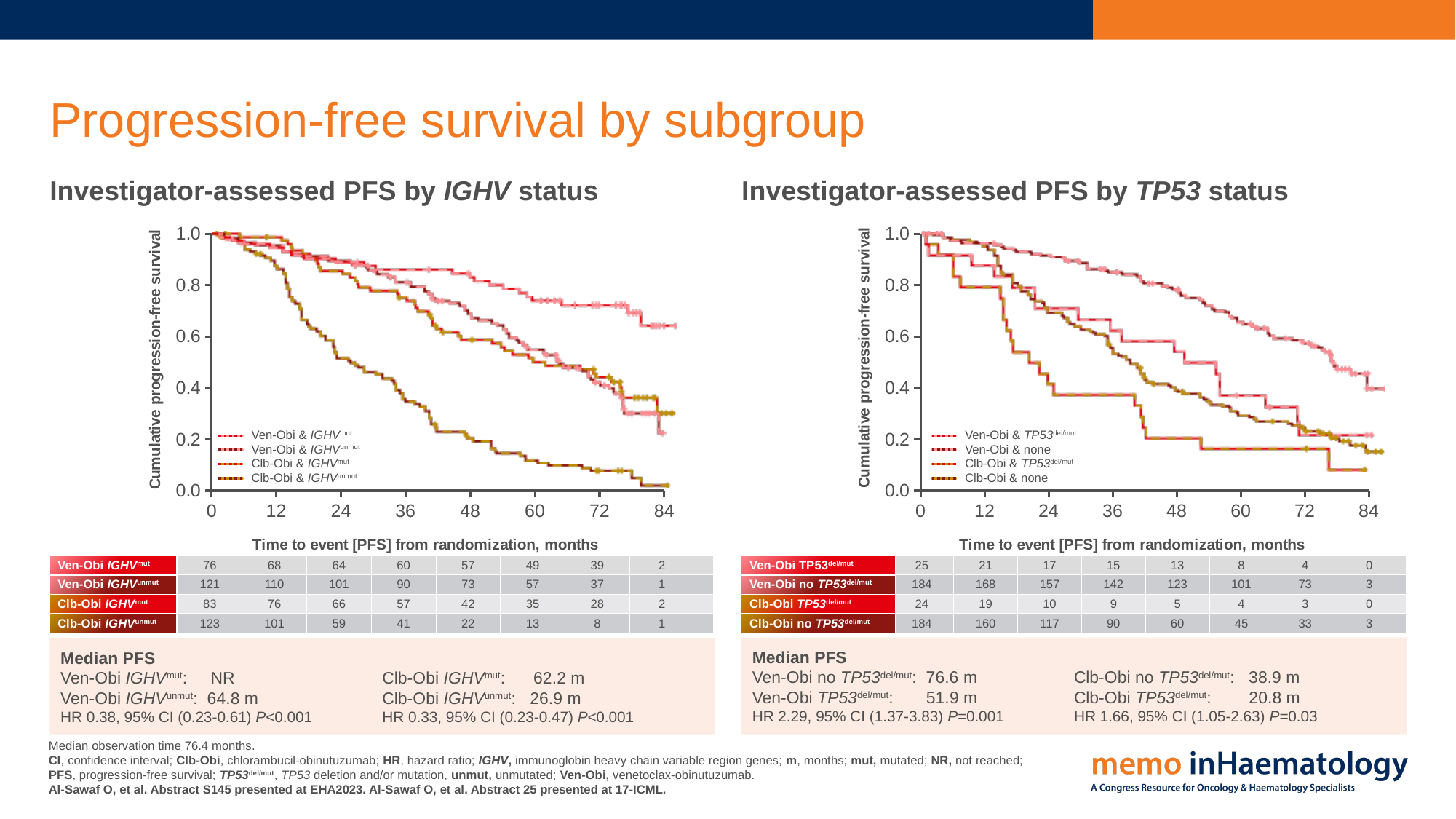
In the chart 'Investigator-assessed PFS by IGHV status', how many patients were at risk at 0 months in the Ven-Obi IGHVunmut group? 121 In the chart 'Investigator-assessed PFS by IGHV status', how many series does the legend list? 4 In the chart 'Investigator-assessed PFS by IGHV status', what is the median PFS for Clb-Obi IGHVmut? 62.2 m In the chart 'Investigator-assessed PFS by TP53 status', what is the difference in the number at risk at 24 months between Ven-Obi no TP53del/mut and Clb-Obi no TP53del/mut? 40 In the chart 'Investigator-assessed PFS by TP53 status', do the survival curves rise or fall as time increases along the x axis? fall In the chart 'Investigator-assessed PFS by IGHV status', is the Ven-Obi IGHVmut curve at 72 months greater or less than 0.6? greater In the chart 'Investigator-assessed PFS by IGHV status', what is the median PFS for Ven-Obi IGHVmut? NR In the chart 'Investigator-assessed PFS by IGHV status', how many patients were at risk at 48 months in the Clb-Obi IGHVunmut group? 22 In the chart 'Investigator-assessed PFS by TP53 status', which group has the lowest median PFS? Clb-Obi TP53del/mut (20.8 m) What is the x-axis label of the chart 'Investigator-assessed PFS by TP53 status'? Time to event [PFS] from randomization, months In the chart 'Investigator-assessed PFS by IGHV status', which is larger: the median PFS for Ven-Obi IGHVunmut or for Clb-Obi IGHVmut? Ven-Obi IGHVunmut What kind of chart is 'Investigator-assessed PFS by TP53 status'? Line chart (Kaplan-Meier survival curve)